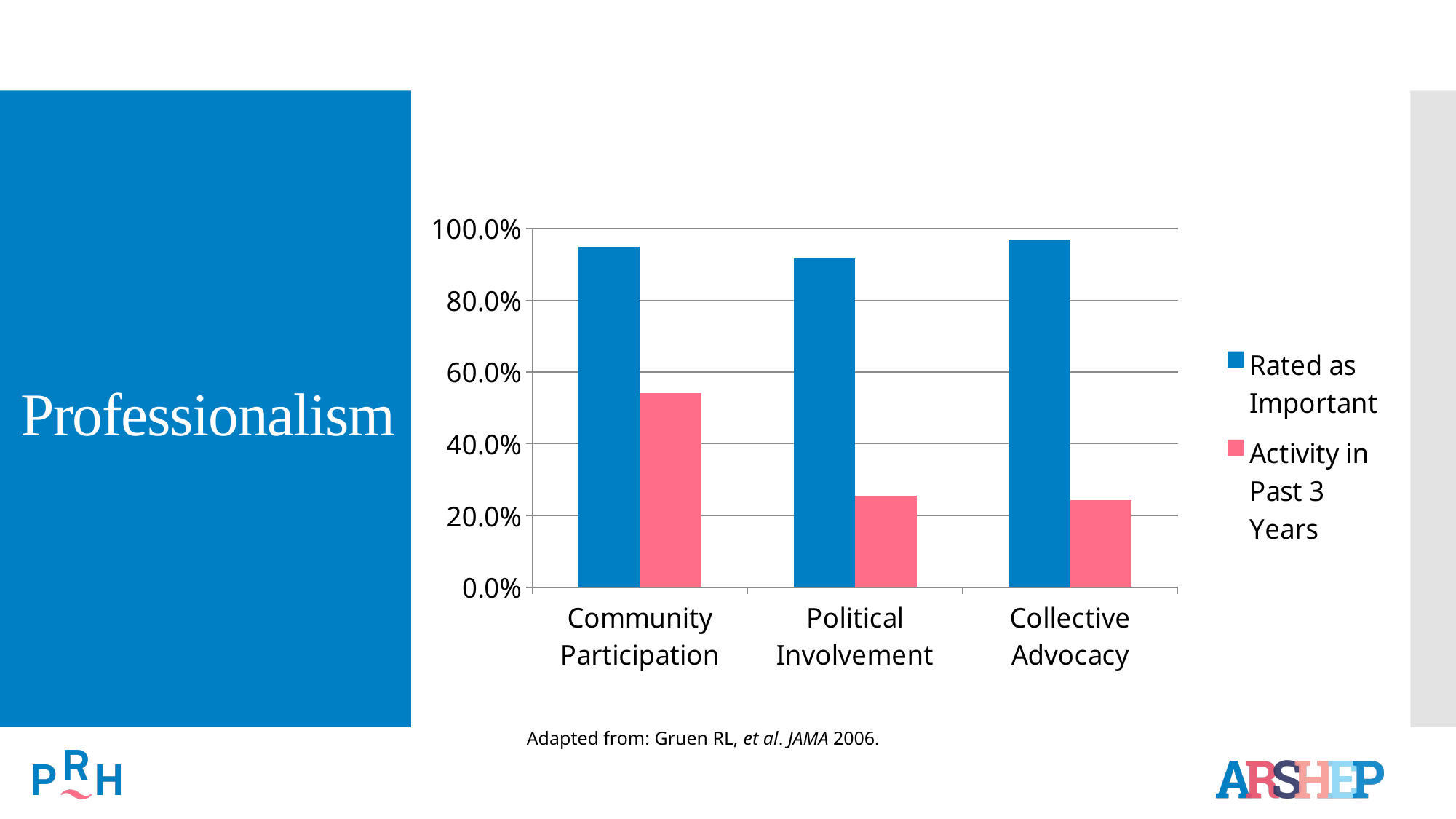
Which category has the lowest value for the Rated as Important series? Political Involvement Is the Rated as Important value for Collective Advocacy greater or less than 80.0%? greater Is the Activity in Past 3 Years value for Community Participation greater or less than 40.0%? greater Is the Activity in Past 3 Years value for Collective Advocacy greater or less than 20.0%? greater What colour are the bars for the Activity in Past 3 Years series? pink For Political Involvement, which series has the larger value: Rated as Important or Activity in Past 3 Years? Rated as Important Which is larger: the Activity in Past 3 Years value for Community Participation or for Political Involvement? Community Participation How many series does the legend list? 2 What kind of chart is shown on the slide? bar chart Which category has the highest value for the Activity in Past 3 Years series? Community Participation How many categories are shown on the x axis? 3